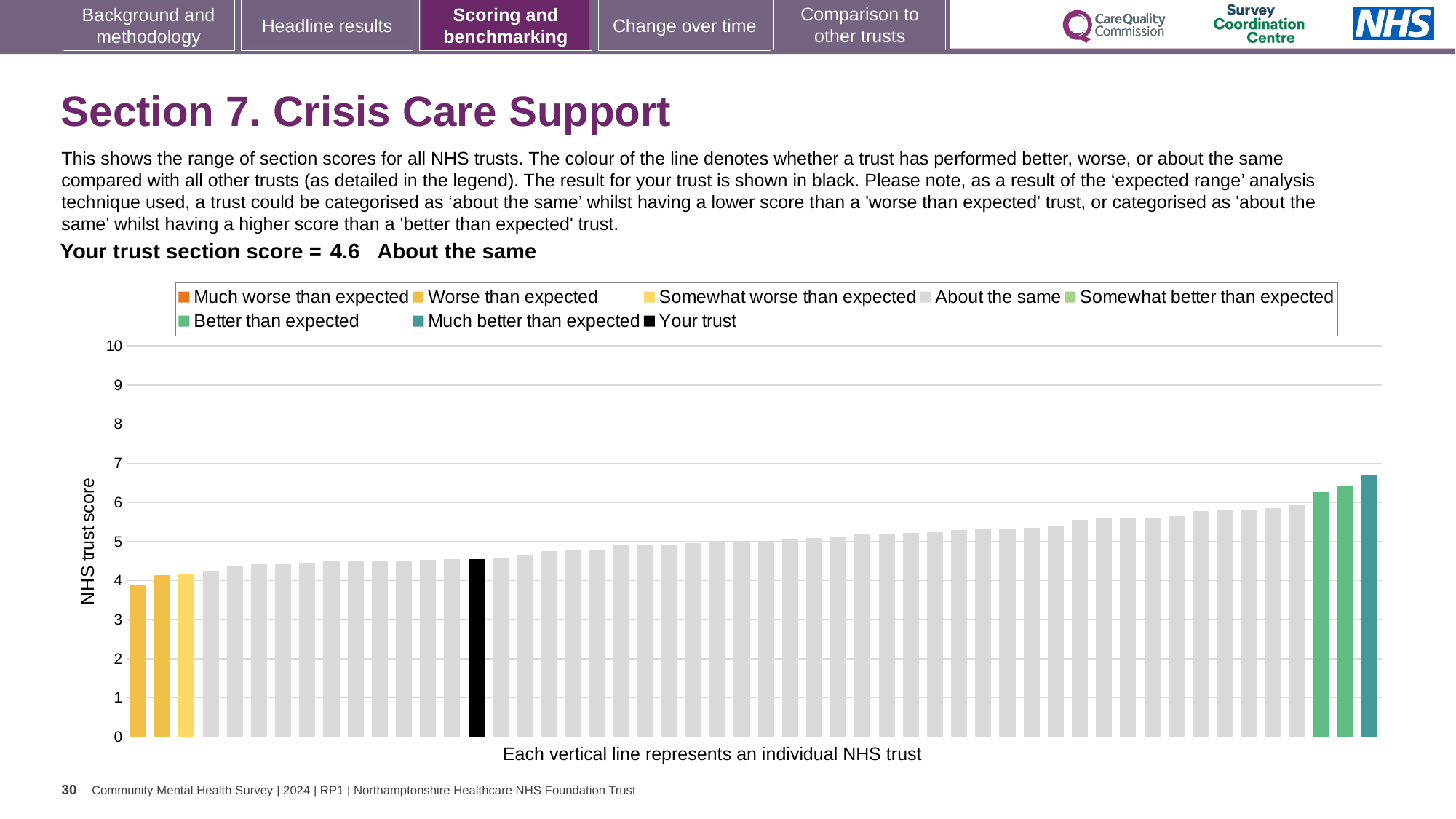
Is the value of the highest bar greater or less than 6? greater Which legend category does the lowest bar belong to? Worse than expected Which legend category does the highest bar belong to? Much better than expected What colour is the bar representing your trust? black What is the label on the y axis of the chart? NHS trust score How many bars are coloured as 'Better than expected'? 2 Is the value of the lowest bar greater or less than 3? greater What is the section score for your trust shown on the slide? 4.6 How many entries does the chart legend list? 8 What type of chart is shown on the slide? bar chart Is the value for your trust (the black bar) greater or less than 5? less Do the bar values rise or fall from left to right along the x axis? rise